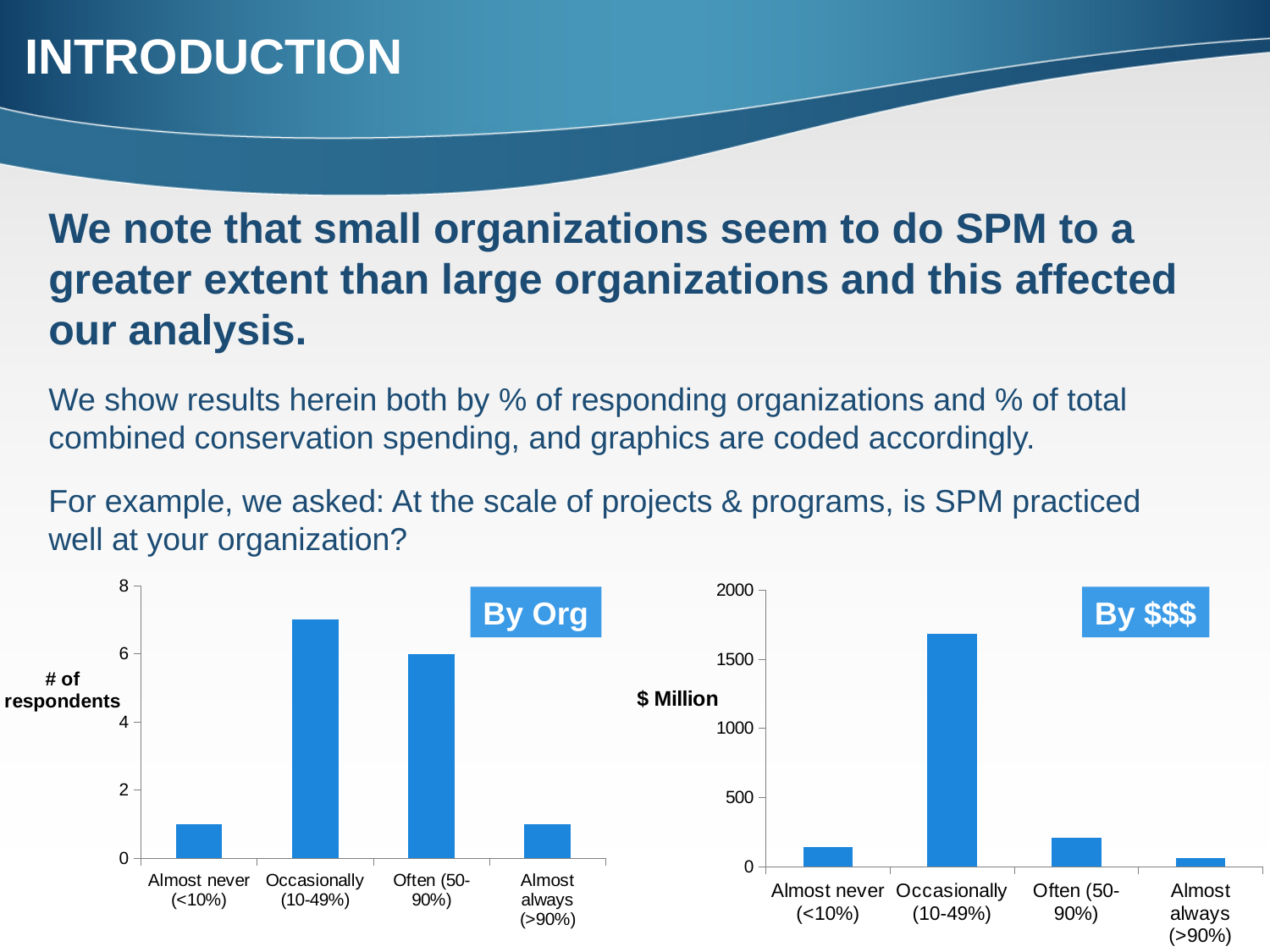
In the 'By Org' chart, is the value for Occasionally (10-49%) greater or less than 6? greater What is the y-axis label of the 'By $$$' chart? $ Million In the 'By Org' chart, which category has the highest number of respondents? Occasionally (10-49%) What type of chart is the 'By Org' chart? bar chart In the 'By Org' chart, what is the value for Often (50-90%)? 6 In the 'By Org' chart, is the value for Almost never (<10%) greater or less than 2? less In the 'By $$$' chart, which category has the lowest value? Almost always (>90%) In the 'By $$$' chart, which is larger: the value for Often (50-90%) or the value for Almost always (>90%)? Often (50-90%) In the 'By $$$' chart, is the value for Often (50-90%) greater or less than 500? less In the 'By Org' chart, how many categories are shown on the x axis? 4 In the 'By $$$' chart, which category has the highest value? Occasionally (10-49%)